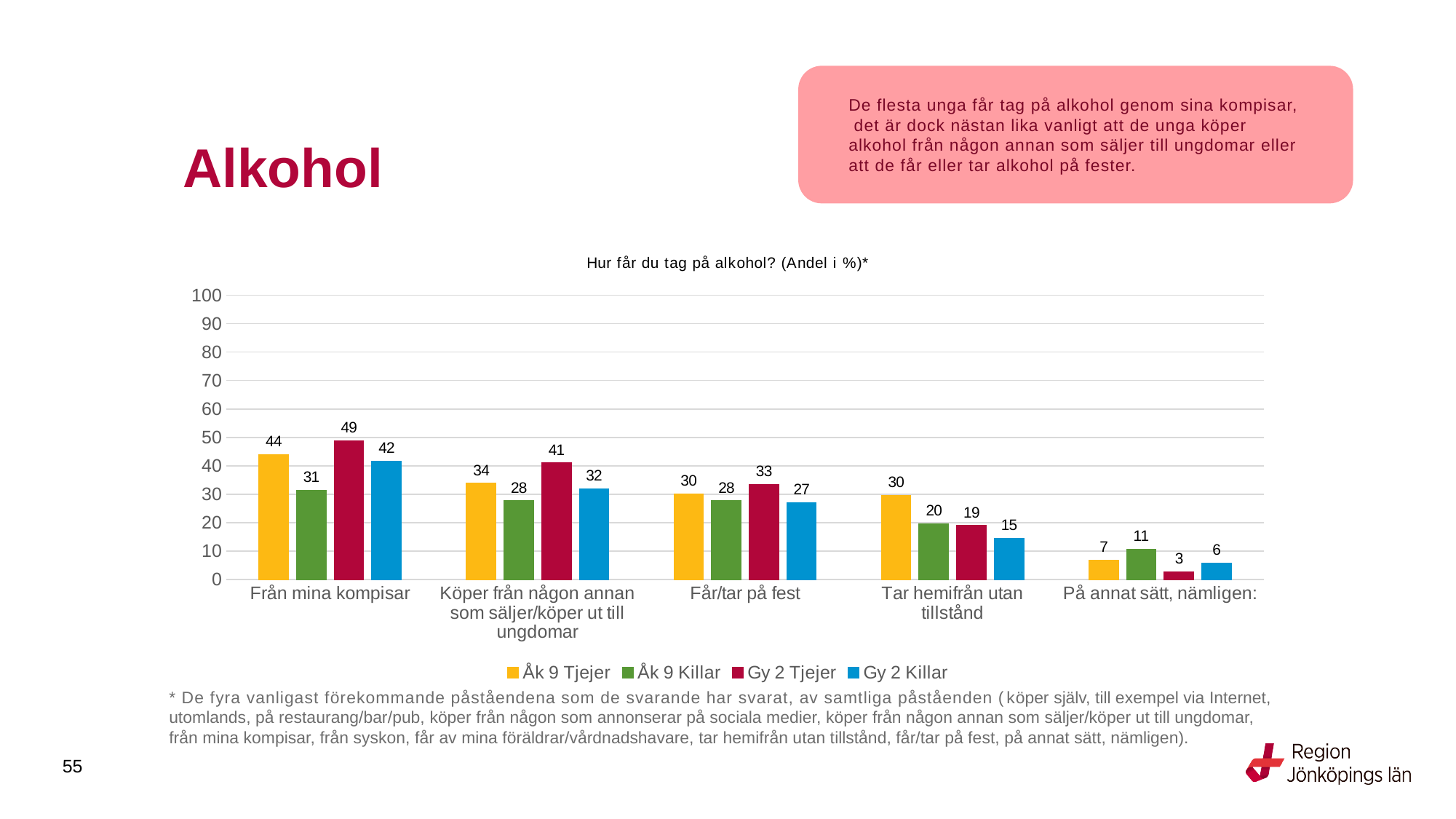
In the category 'Får/tar på fest', which series has the larger value: Åk 9 Tjejer or Gy 2 Killar? Åk 9 Tjejer What kind of chart is shown on the slide? Bar chart How many categories are shown on the x axis? 5 How many series does the legend list? 4 What is the value for Gy 2 Killar in the category 'Tar hemifrån utan tillstånd'? 15 What is the value for Gy 2 Tjejer in the category 'Från mina kompisar'? 49 What is the value for Åk 9 Killar in the category 'Köper från någon annan som säljer/köper ut till ungdomar'? 28 What is the difference between the Gy 2 Tjejer and Åk 9 Killar values in the category 'Från mina kompisar'? 18 Which category has the lowest value for Gy 2 Tjejer? På annat sätt, nämligen: What is the title of the chart? Hur får du tag på alkohol? (Andel i %)* Do the values for Åk 9 Tjejer rise or fall from left to right across the categories? Fall Which category has the highest value for Åk 9 Tjejer? Från mina kompisar